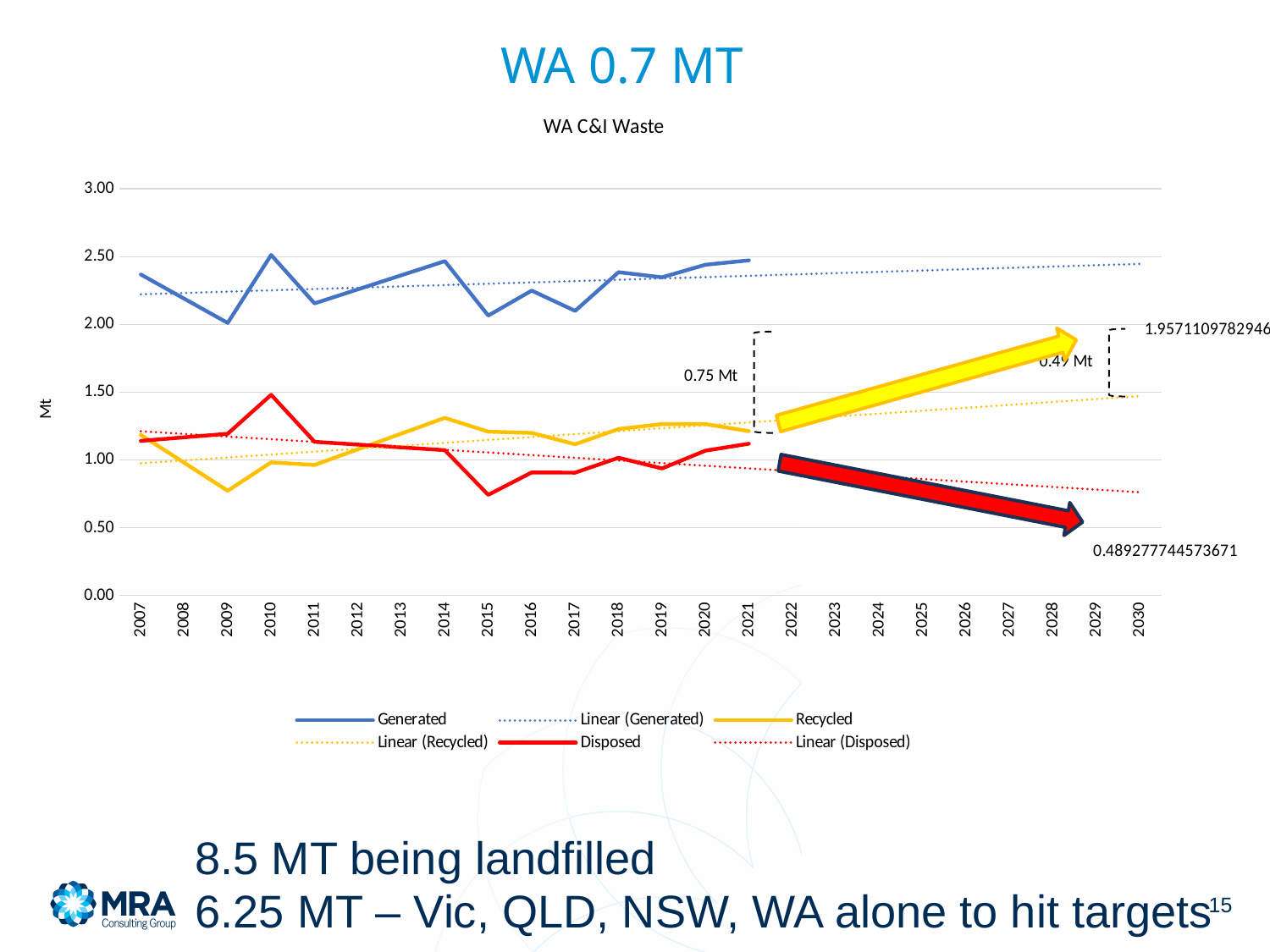
Is the Generated value for 2007 greater or less than 2.00? greater What is the label on the y axis of the chart? Mt Is the Recycled value for 2009 greater or less than 1.00? less In which year is the Disposed line at its lowest? 2015 Does the Linear (Disposed) trendline rise or fall from 2007 to 2030? fall In which year is the Disposed line at its highest? 2010 What type of chart is shown on the slide? line chart In 2009, which is larger, the Recycled value or the Disposed value? Disposed How many years are shown on the x axis of the chart? 24 In which year is the Recycled line at its lowest? 2009 What is the title of the chart? WA C&I Waste How many series does the chart legend list? 6